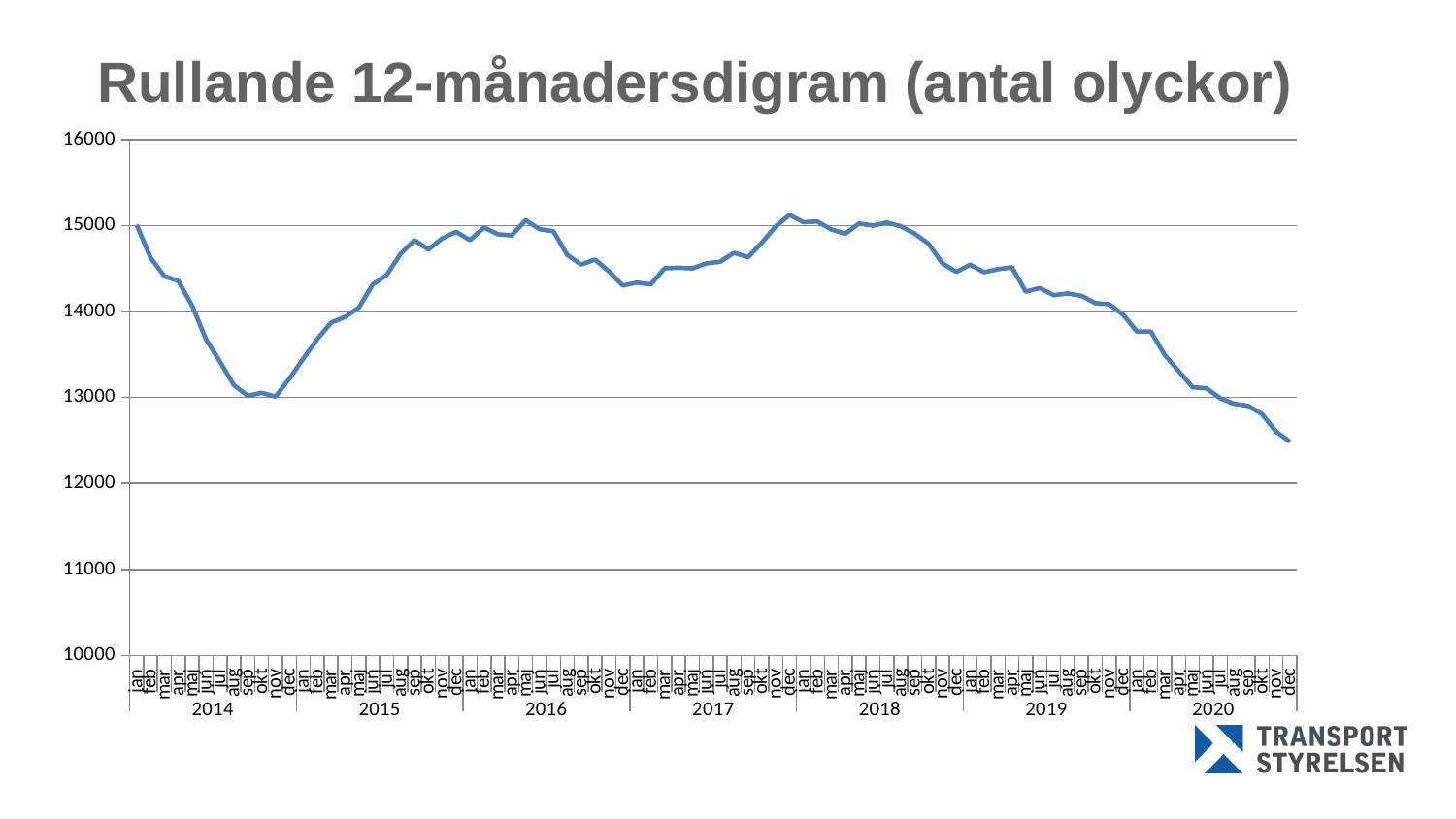
Is the value for dec 2020 greater or less than 13000? less What kind of chart is shown on the slide? line chart Is the value for jan 2016 greater or less than 14500? greater Is the value for okt 2014 greater or less than 13500? less Do the values rise or fall from jan 2019 to dec 2020? fall Which is higher, the value for jan 2014 or the value for dec 2020? jan 2014 Do the values rise or fall from jan 2014 to okt 2014? fall How many years are labelled along the x axis of the chart? 7 Which month has the lowest value on the chart? dec 2020 How many lines are plotted on the chart? 1 What is the title of the chart? Rullande 12-månadersdigram (antal olyckor)